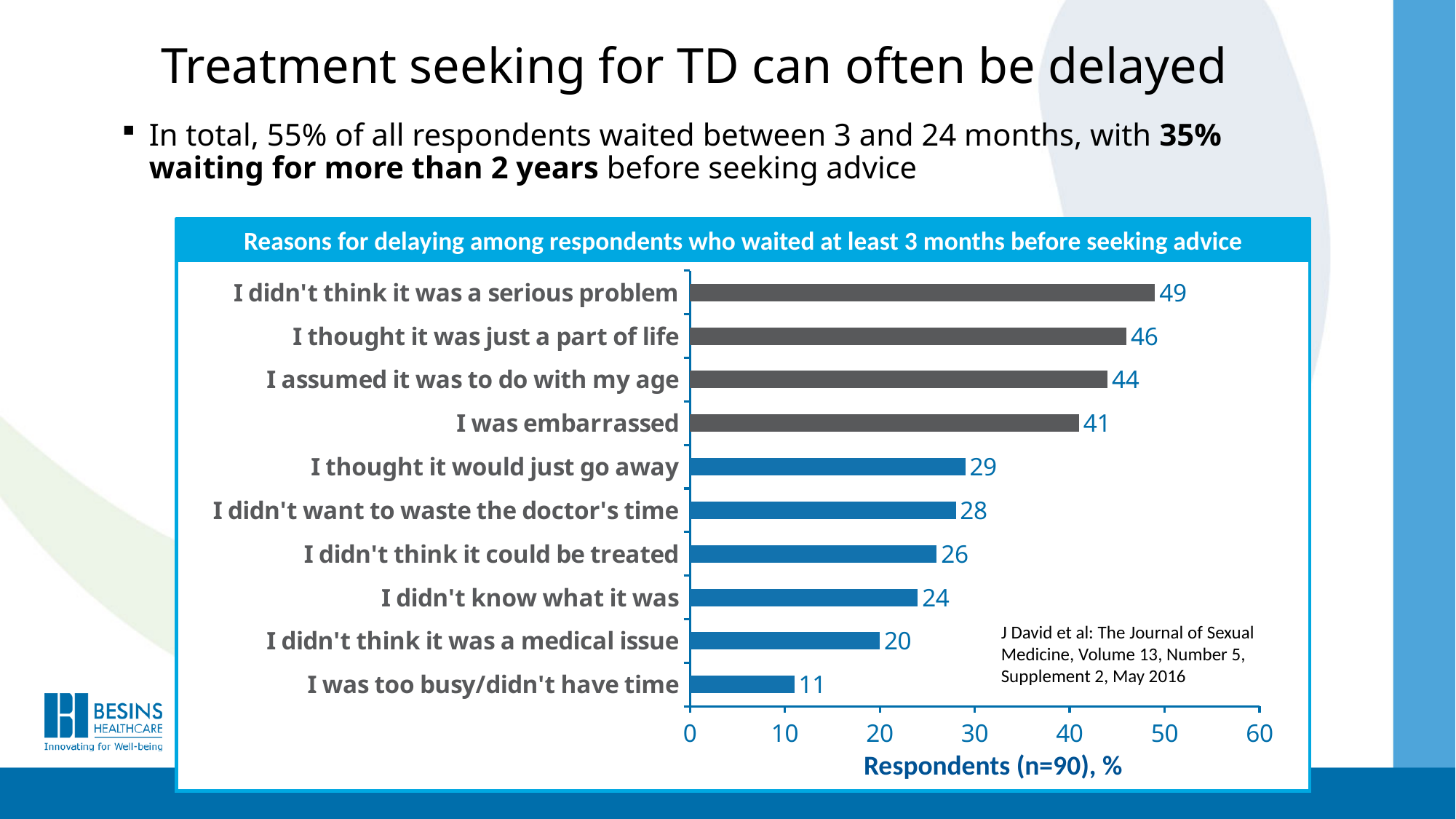
How many reasons are shown in the chart? 10 What is the value for "I didn't think it was a serious problem"? 49 Is the value for "I assumed it was to do with my age" greater or less than 40? greater Which is larger: "I didn't know what it was" or "I didn't think it was a medical issue"? I didn't know what it was Which reason has the highest value? I didn't think it was a serious problem Which reason has the lowest value? I was too busy/didn't have time What is the value for "I was embarrassed"? 41 What is the difference between "I thought it was just a part of life" and "I thought it would just go away"? 17 What is the value for "I was too busy/didn't have time"? 11 What is the title of the chart? Reasons for delaying among respondents who waited at least 3 months before seeking advice What kind of chart is shown on the slide? bar chart What is the label of the horizontal axis? Respondents (n=90), %